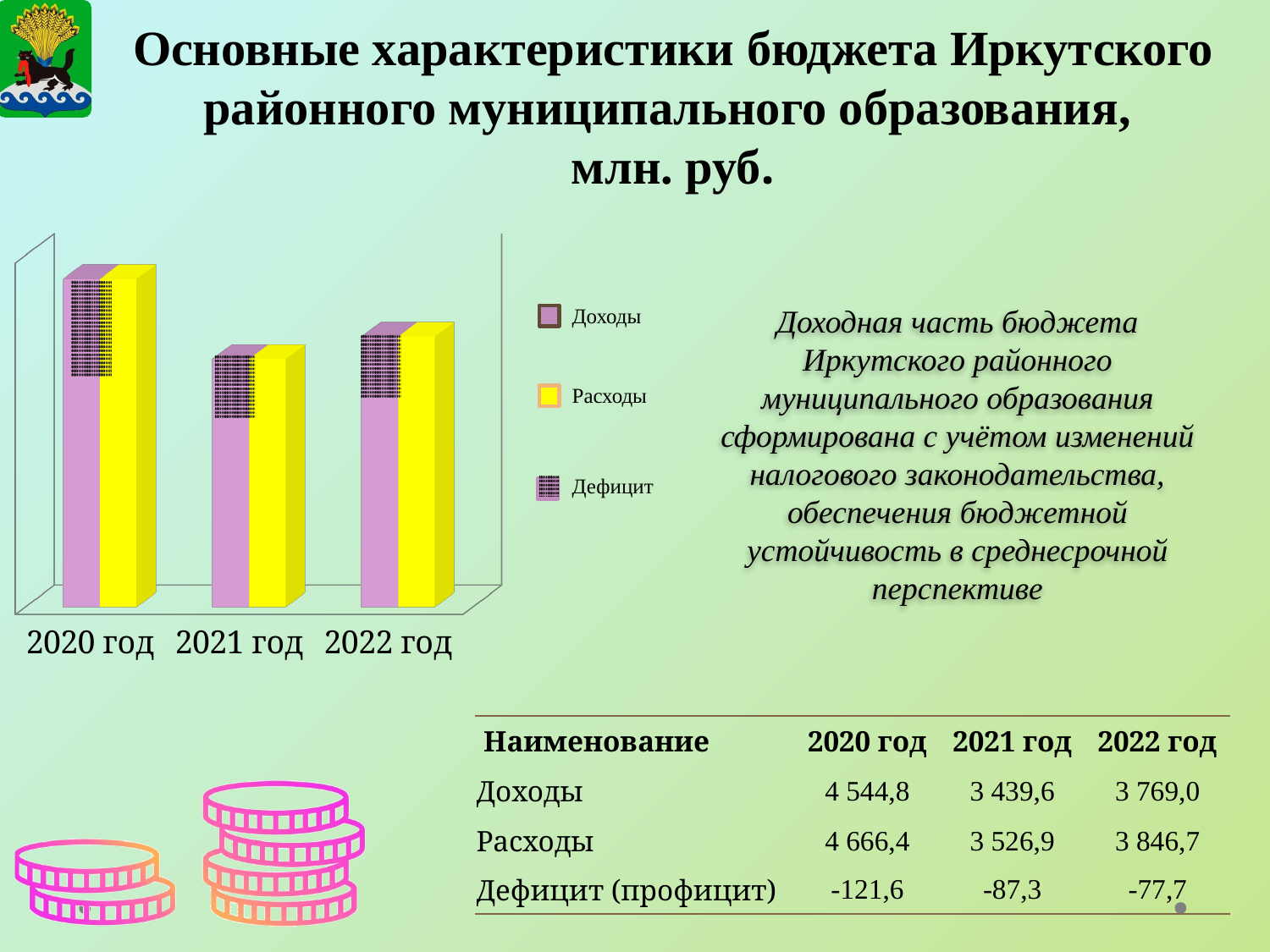
What kind of chart is shown on the slide? bar chart Which year has the lowest Расходы bar? 2021 год By how much do Расходы exceed Доходы in 2020 год, according to the table? 121,6 What is the value of Доходы for 2020 год, as shown in the table? 4 544,8 How many years (categories) are shown on the x axis of the chart? 3 Which is larger, the Доходы bar for 2020 год or the Доходы bar for 2022 год? 2020 год How many series does the chart legend list? 3 Which year has the highest Доходы bar? 2020 год Do the Доходы bars rise or fall from 2020 год to 2021 год? fall What is the value of Дефицит (профицит) for 2021 год, as shown in the table? -87,3 What is the value of Расходы for 2022 год, as shown in the table? 3 846,7 Which legend entry is shown in yellow? Расходы